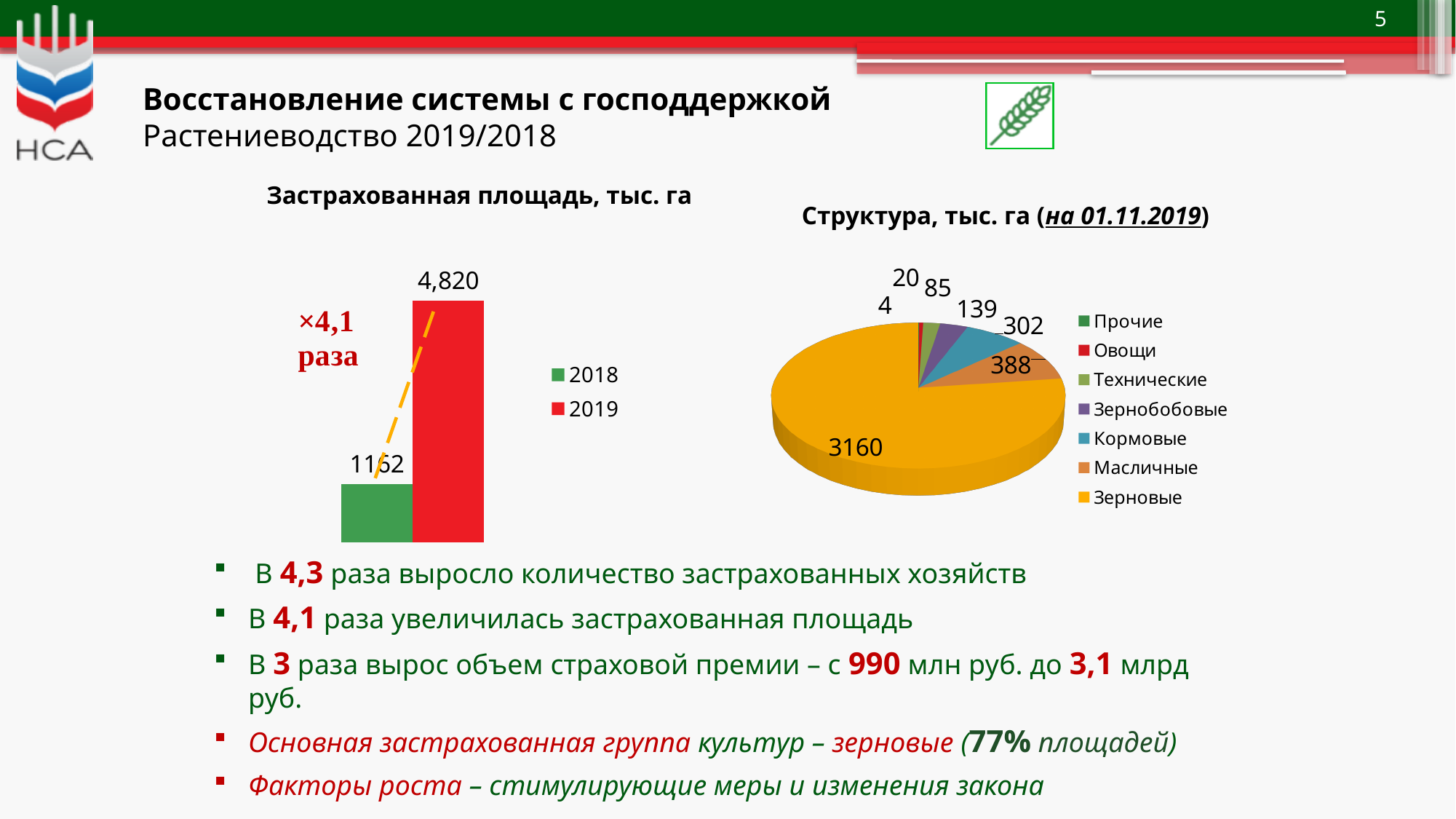
How many categories does the legend of the pie chart 'Структура, тыс. га (на 01.11.2019)' list? 7 In the chart 'Застрахованная площадь, тыс. га', what is the value for 2019? 4,820 In the pie chart 'Структура, тыс. га (на 01.11.2019)', what is the value for Кормовые? 302 In the pie chart 'Структура, тыс. га (на 01.11.2019)', which category has the smallest slice? Прочие In the pie chart 'Структура, тыс. га (на 01.11.2019)', which category has the largest slice? Зерновые In the pie chart 'Структура, тыс. га (на 01.11.2019)', what is the value for Зерновые? 3160 In the pie chart 'Структура, тыс. га (на 01.11.2019)', what is the value for Масличные? 388 In the chart 'Застрахованная площадь, тыс. га', which year has the higher value, 2018 or 2019? 2019 In the chart 'Застрахованная площадь, тыс. га', what is the value for 2018? 1162 What type of chart is the chart titled 'Застрахованная площадь, тыс. га'? bar chart How many series does the legend of the chart 'Застрахованная площадь, тыс. га' list? 2 What type of chart is the chart titled 'Структура, тыс. га (на 01.11.2019)'? pie chart